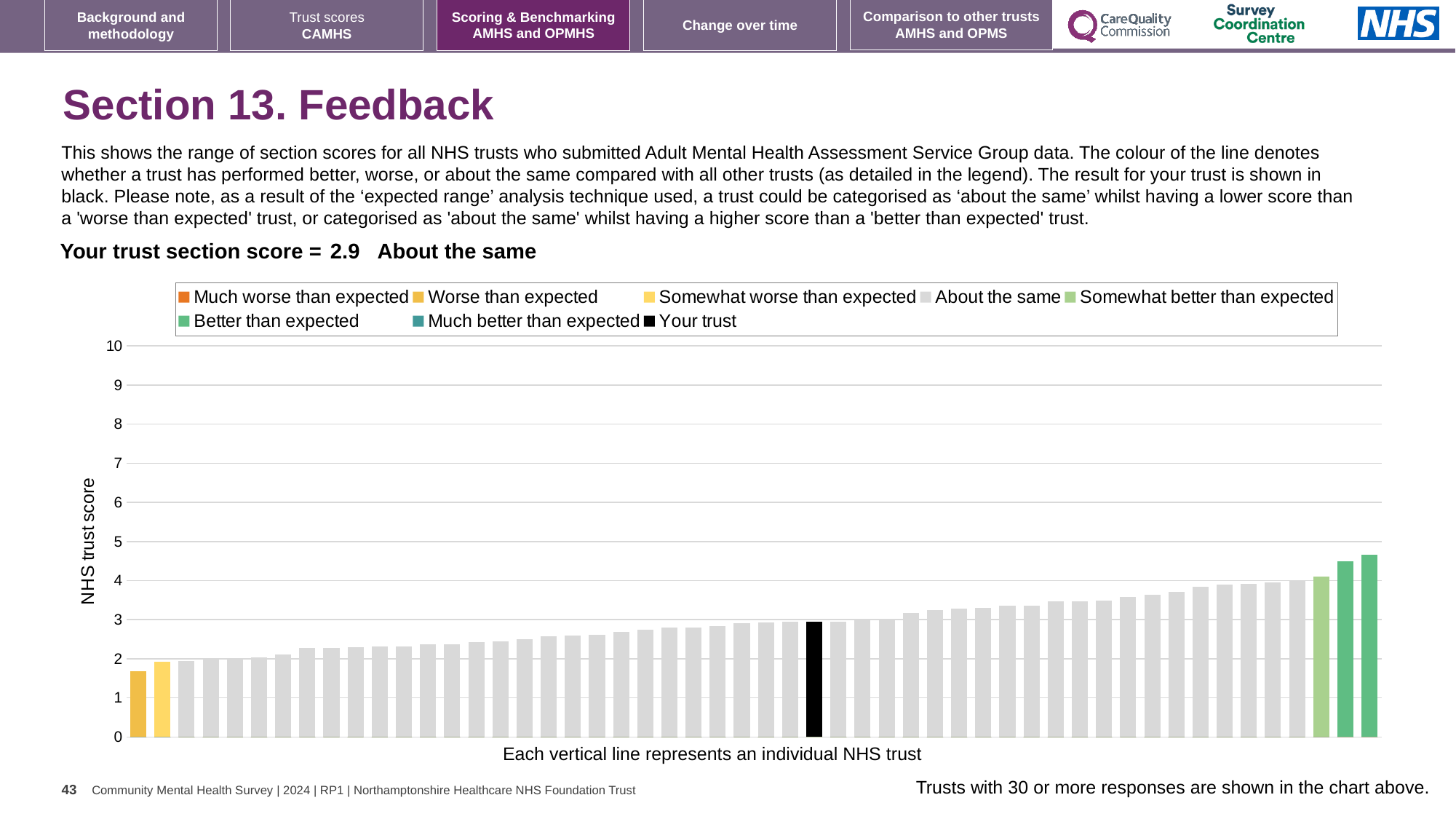
Which legend category does the tallest bar belong to? Better than expected Which category is your trust's section score placed in? About the same Do the bar values rise or fall from left to right along the x axis? rise How many bars are coloured as 'Somewhat better than expected'? 1 Is the value of the tallest bar in the chart greater or less than 4? greater How many entries does the chart legend list? 8 What kind of chart is shown on the slide? bar chart Is the value of the shortest bar in the chart greater or less than 2? less Is the value for your trust (the black bar) greater or less than 3? less What is the label on the vertical axis of the chart? NHS trust score How many bars are coloured as 'Better than expected'? 2 What is the section score for your trust? 2.9